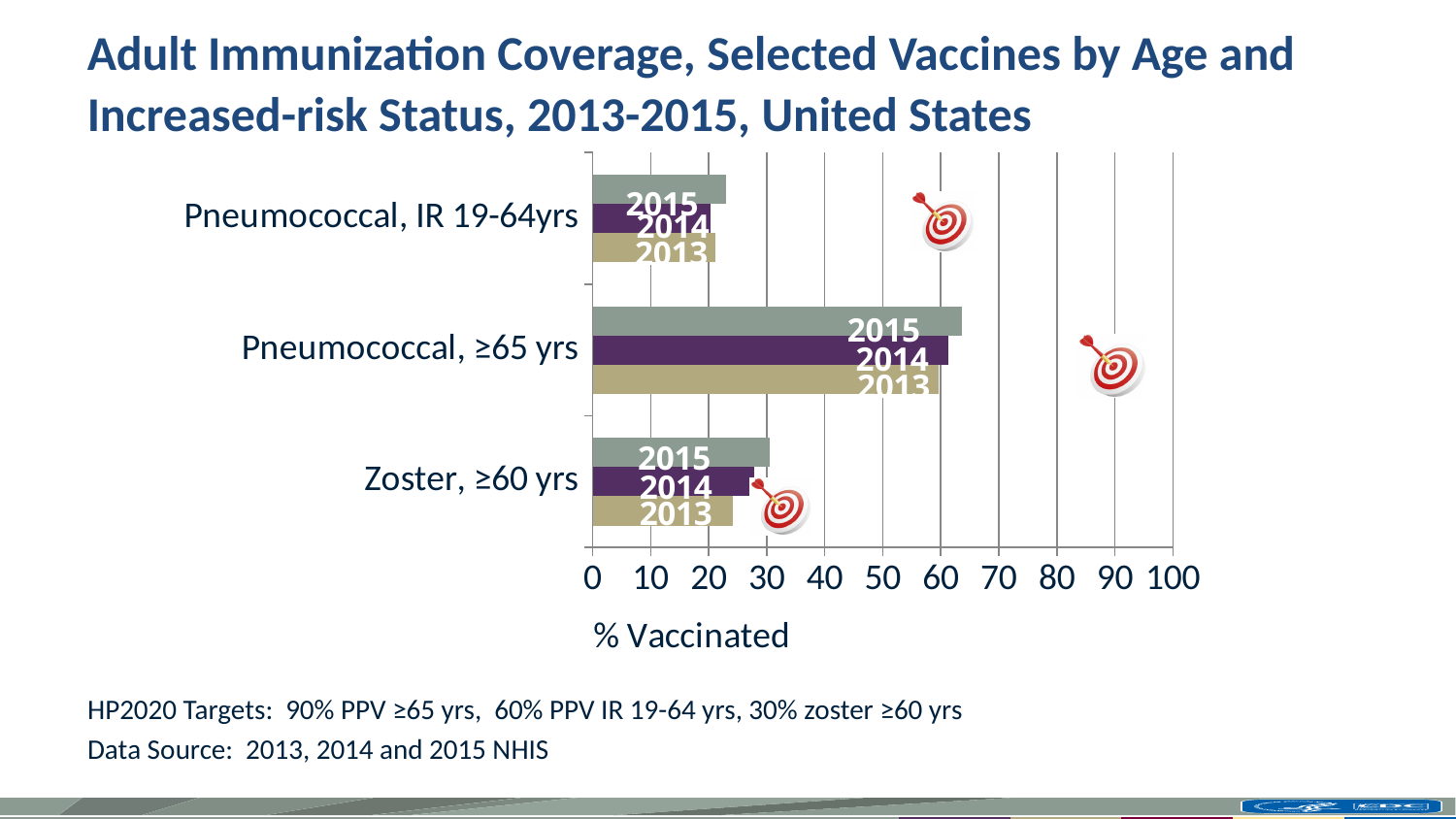
How many years (series) are plotted for each category? 3 How many vaccine/age categories are plotted on the chart? 3 Which category has the lowest 2015 coverage? Pneumococcal, IR 19-64yrs According to the slide, what is the HP2020 target for zoster vaccination in adults ≥60 yrs? 30% Which is larger: the 2015 value for Zoster, ≥60 yrs or the 2015 value for Pneumococcal, IR 19-64yrs? Zoster, ≥60 yrs What kind of chart is shown on the slide? bar chart Which category has the highest 2015 coverage? Pneumococcal, ≥65 yrs Is the 2015 value for Pneumococcal, IR 19-64yrs greater or less than 30? less Is the 2013 value for Zoster, ≥60 yrs greater or less than 30? less What is the title of the x axis? % Vaccinated For Zoster, ≥60 yrs, does coverage rise or fall from 2013 to 2015? rise Is the 2015 value for Pneumococcal, ≥65 yrs greater or less than 60? greater